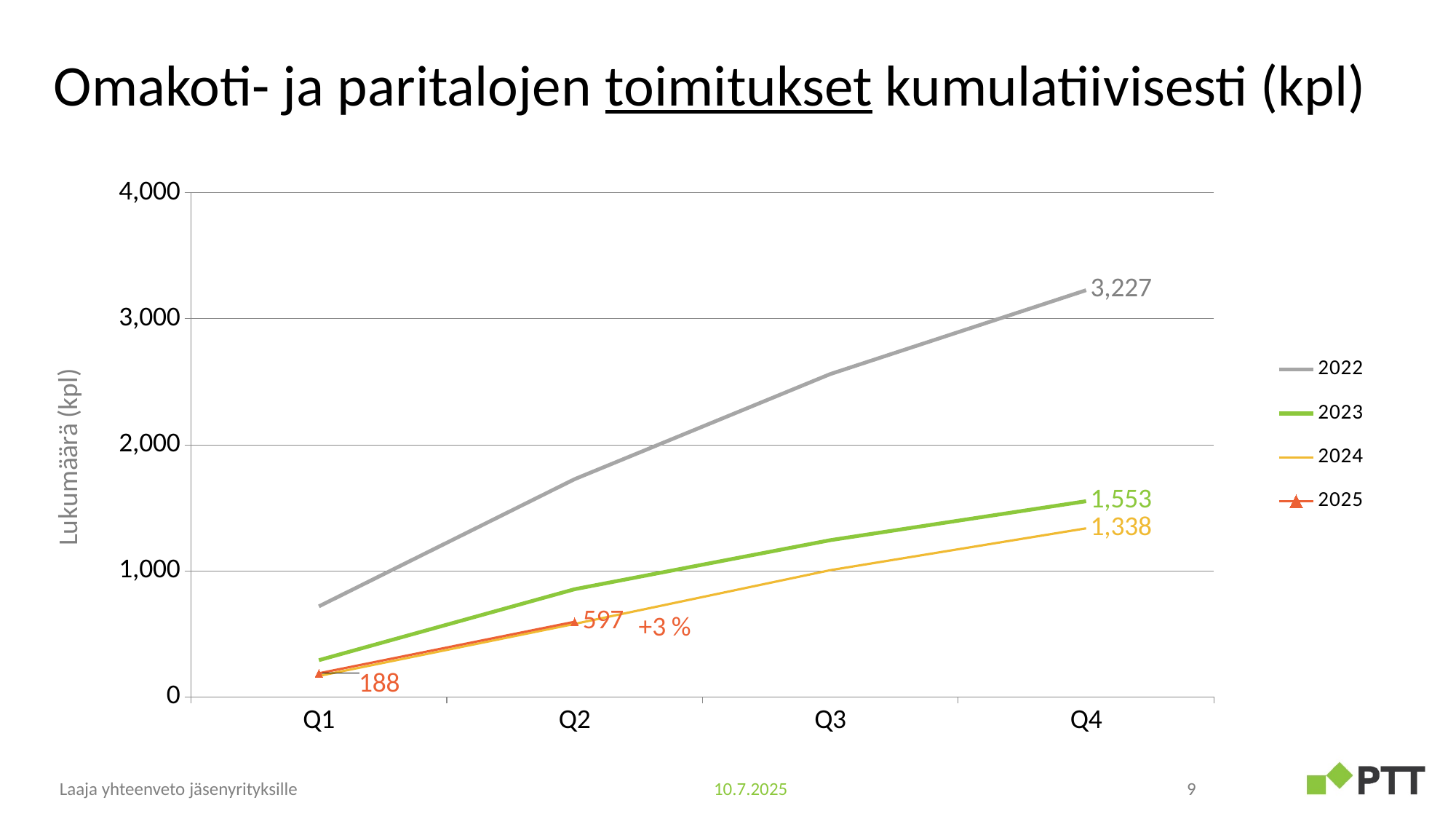
By how much did the 2025 series increase from Q1 to Q2? 409 What is the value for 2025 at Q2? 597 What is the value for 2023 at Q4? 1,553 What is the difference between the 2023 and 2024 values at Q4? 215 Is the value for 2022 at Q2 greater or less than 1,000? greater What is the value for 2025 at Q1? 188 What is the value for 2022 at Q4? 3,227 What is the value for 2024 at Q4? 1,338 How many series does the legend list? 4 What kind of chart is shown on the slide? line chart Which series has the highest value at Q4? 2022 What is the y-axis title of the chart? Lukumäärä (kpl)